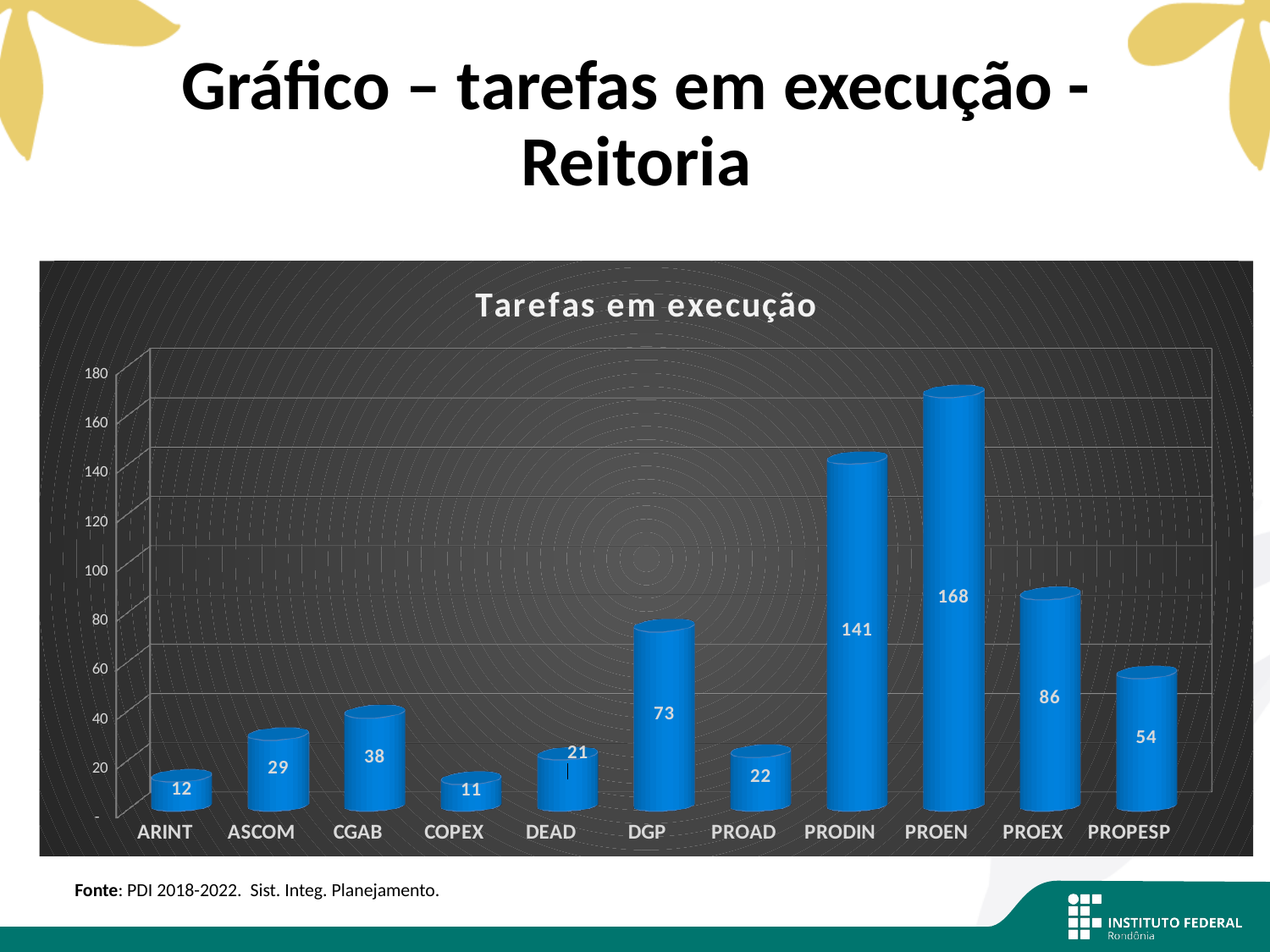
What is the value for PROEN in the chart? 168 Is the value for PRODIN greater or less than 100? greater Which category has the lowest value? COPEX What kind of chart is shown on the slide? bar chart What is the value for DGP in the chart? 73 Which category has the highest value? PROEN Which is larger, the value for PROEX or the value for PROPESP? PROEX What is the value for COPEX in the chart? 11 What is the title of the chart? Tarefas em execução What is the difference between the values for PROEN and PRODIN? 27 How many categories are shown on the x axis? 11 What is the difference between the values for CGAB and ASCOM? 9